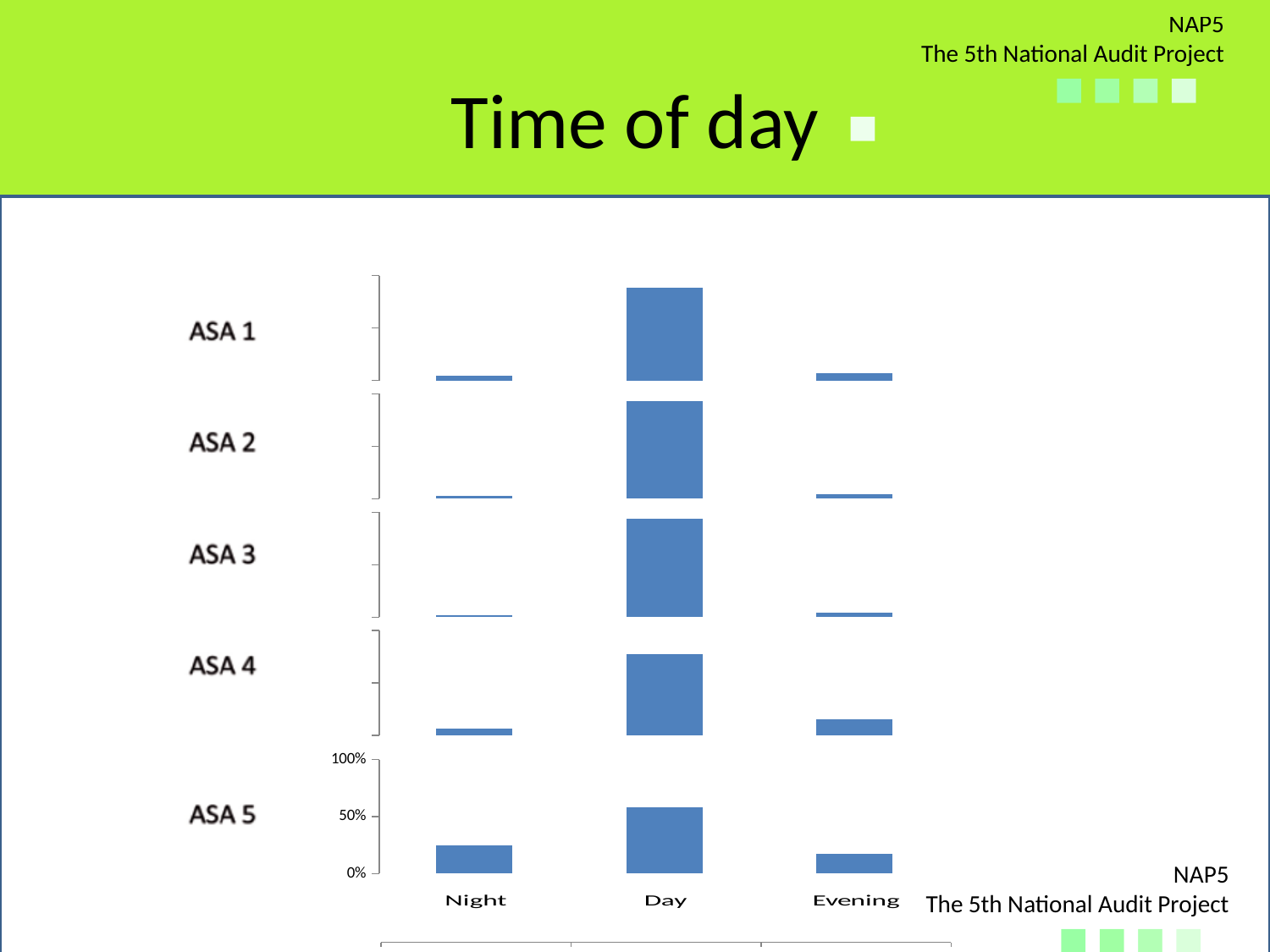
What kind of chart is shown on the slide? bar chart What are the three tick labels shown on the y axis of the ASA 5 panel? 0%, 50%, 100% In the ASA 1 panel, which time of day has the highest bar? Day In the ASA 5 panel, is the value for Night greater or less than 50%? less In the ASA 5 panel, which time of day has the lowest bar? Evening In the ASA 3 panel, which is larger, the Day bar or the Night bar? Day In the ASA 4 panel, which is larger, the Evening bar or the Night bar? Evening How many ASA panels (rows) does the chart contain? 5 In the ASA 5 panel, is the value for Evening greater or less than 50%? less In the ASA 5 panel, which time of day has the highest bar? Day How many time-of-day categories are shown along the x axis? 3 What is the title of the slide containing the chart? Time of day